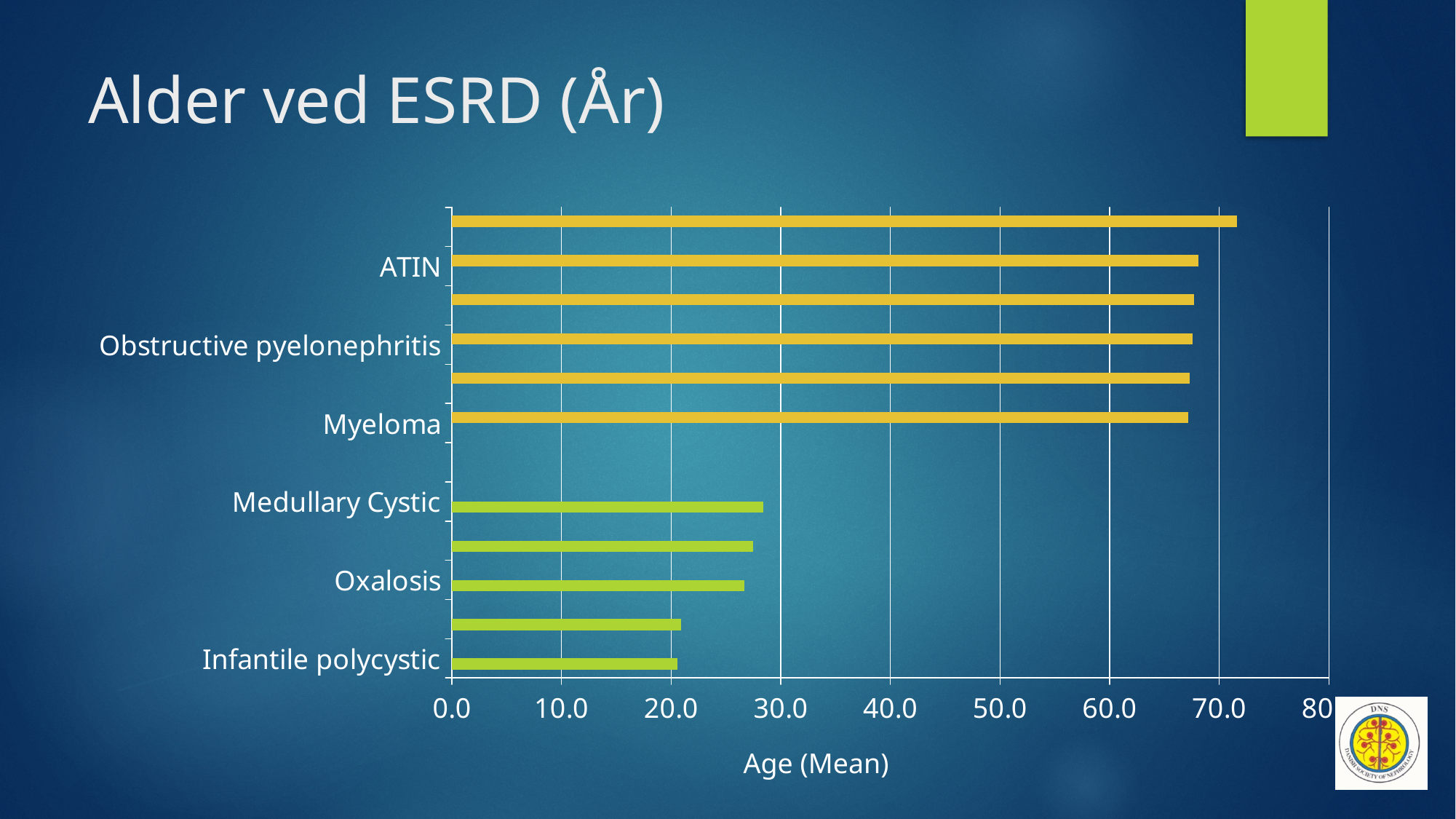
Is the value for Oxalosis greater or less than 20.0? greater Is the value for ATIN greater or less than 60.0? greater What is the title of the x axis of the chart? Age (Mean) Is the value for Myeloma greater or less than 60.0? greater Among the labelled categories, which has the lowest value? Infantile polycystic What kind of chart is shown on the slide? bar chart Which has the larger value, Oxalosis or Infantile polycystic? Oxalosis What is the title of the slide containing the chart? Alder ved ESRD (År) Which has the larger value, Myeloma or Medullary Cystic? Myeloma